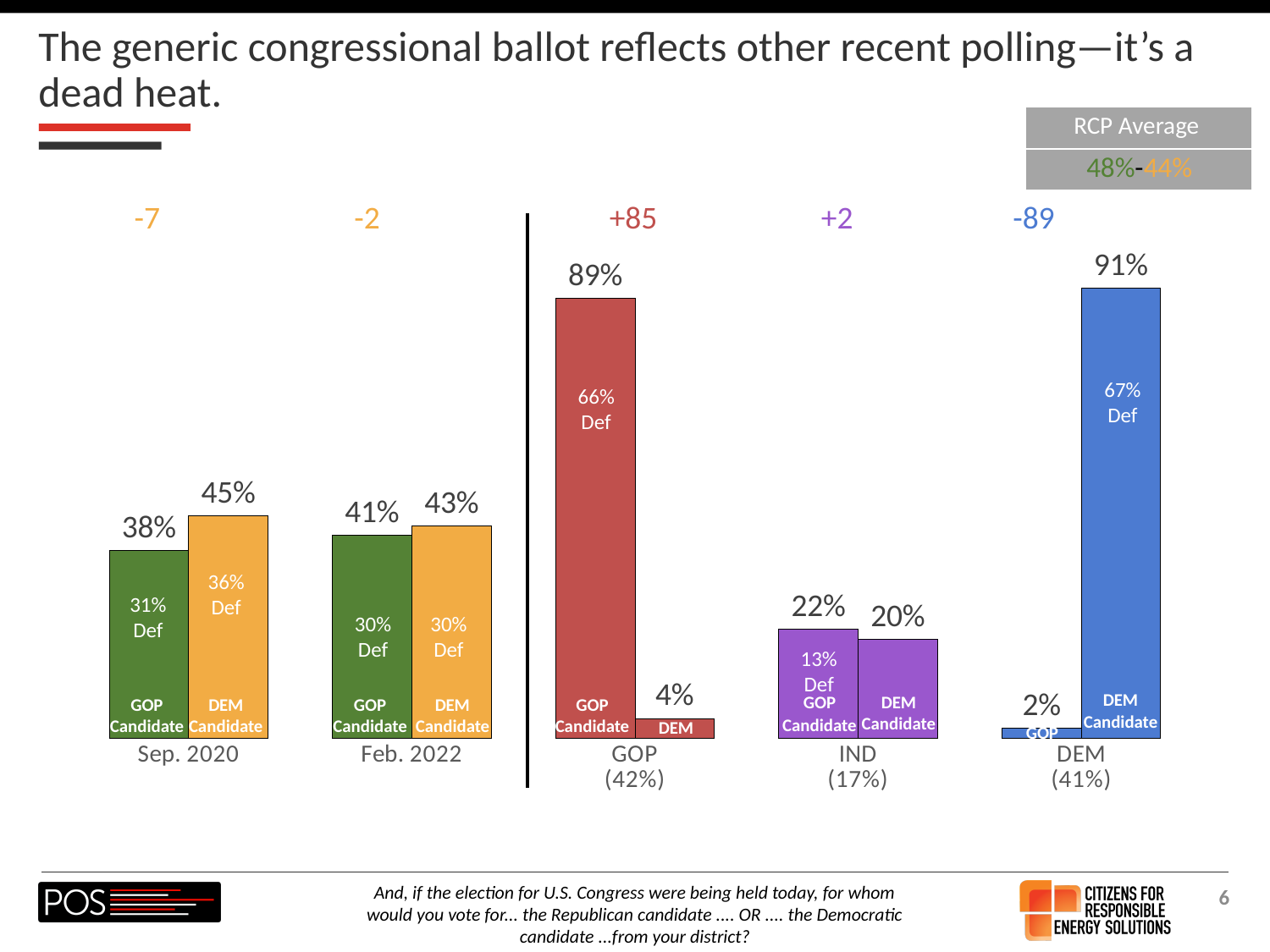
Among IND respondents, what percentage said they would vote for the GOP Candidate? 22% Which group has the highest bar on the chart? DEM Candidate among DEM respondents (91%) What percentage of respondents in Sep. 2020 said they would vote for the GOP Candidate? 38% What kind of chart is shown on the slide? Bar chart Among IND respondents, which is larger: the GOP Candidate value or the DEM Candidate value? GOP Candidate What percentage of respondents in Feb. 2022 said they would vote for the DEM Candidate? 43% What is the difference between the DEM Candidate and GOP Candidate values in Sep. 2020? 7 percentage points Among DEM respondents, what percentage said they would vote for the DEM Candidate? 91% What percentage of Feb. 2022 respondents said they would definitely vote for the GOP Candidate? 30% What is the difference between the GOP Candidate and DEM Candidate values among GOP respondents? 85 percentage points Among GOP respondents, what percentage said they would vote for the GOP Candidate? 89% Which bar is the lowest on the chart? GOP Candidate among DEM respondents (2%)